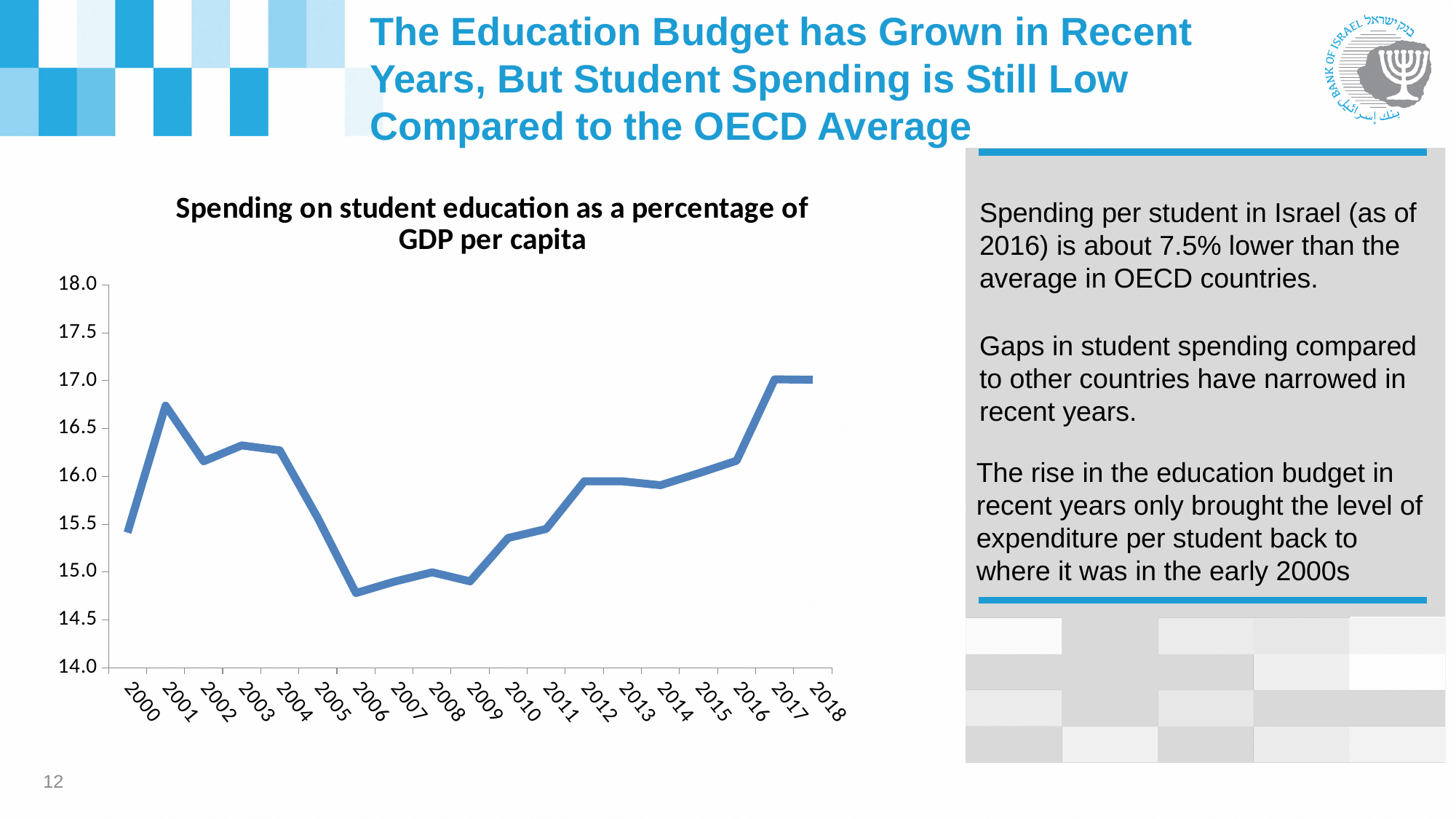
Is the value for 2001 greater or less than 16.5? greater Is the value for 2006 greater or less than 15.0? less Is the value for 2004 greater or less than 16.0? greater Which year has the lowest value on the chart? 2006 What kind of chart is shown on the slide? line chart How many years are plotted on the x axis of the chart? 19 What is the title of the chart? Spending on student education as a percentage of GDP per capita Does the line rise or fall between 2009 and 2017? rise Which year has the larger value, 2001 or 2006? 2001 Which year has the larger value, 2000 or 2016? 2016